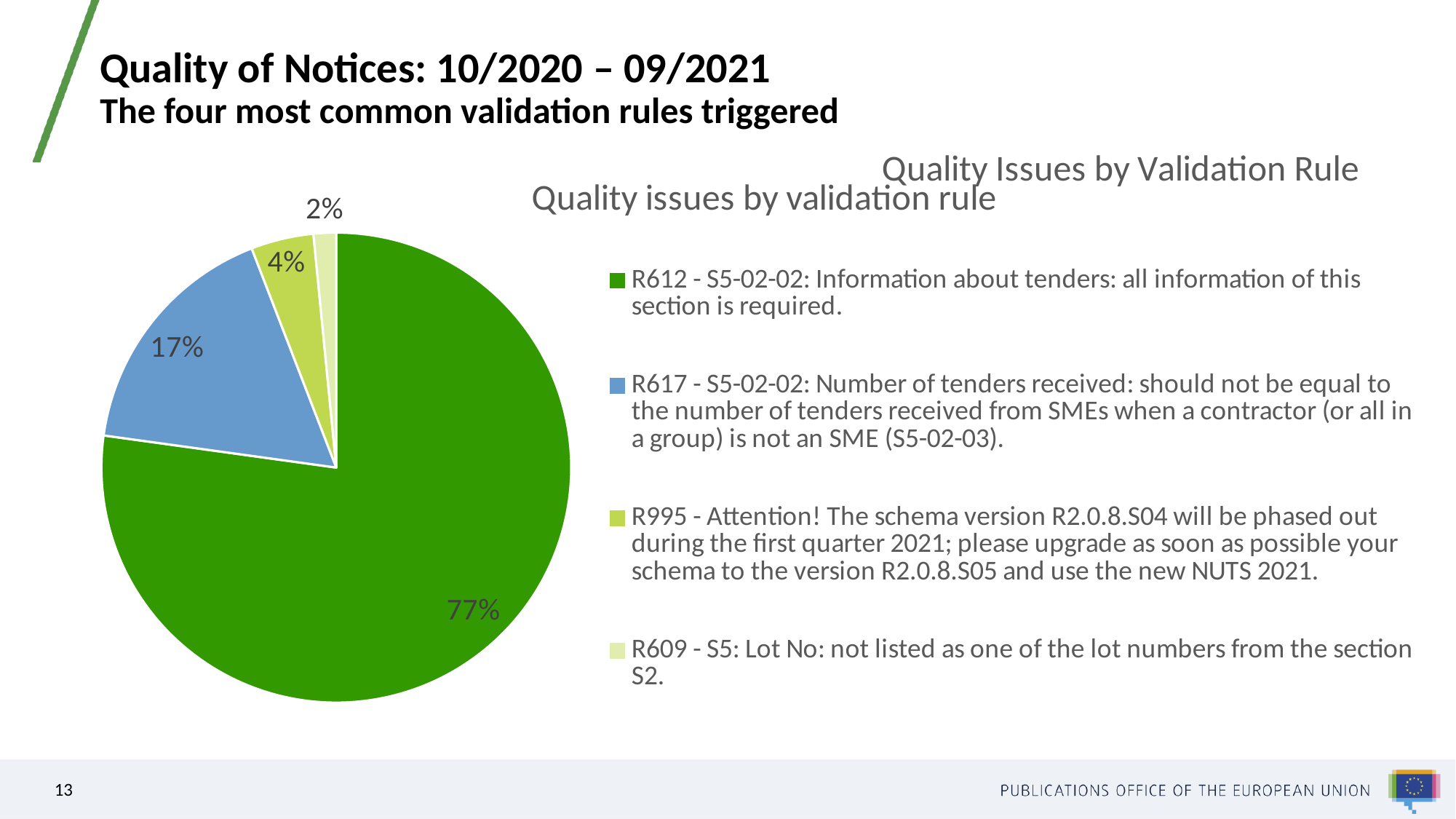
Which slice is larger, R995 or R609? R995 Which validation rule has the largest slice of the pie? R612 What colour is the slice for R617 in the pie chart? blue What share of the pie does R609 (Lot No: not listed as one of the lot numbers from the section S2) account for? 2% What is the difference in percentage points between the R612 slice and the R617 slice? 60 What share of the pie does R995 (schema version R2.0.8.S04 will be phased out) account for? 4% What share of the pie does R617 (Number of tenders received) account for? 17% What kind of chart is shown on the slide? pie chart How many slices does the pie chart have? 4 How many entries does the legend list? 4 Which validation rule has the smallest slice of the pie? R609